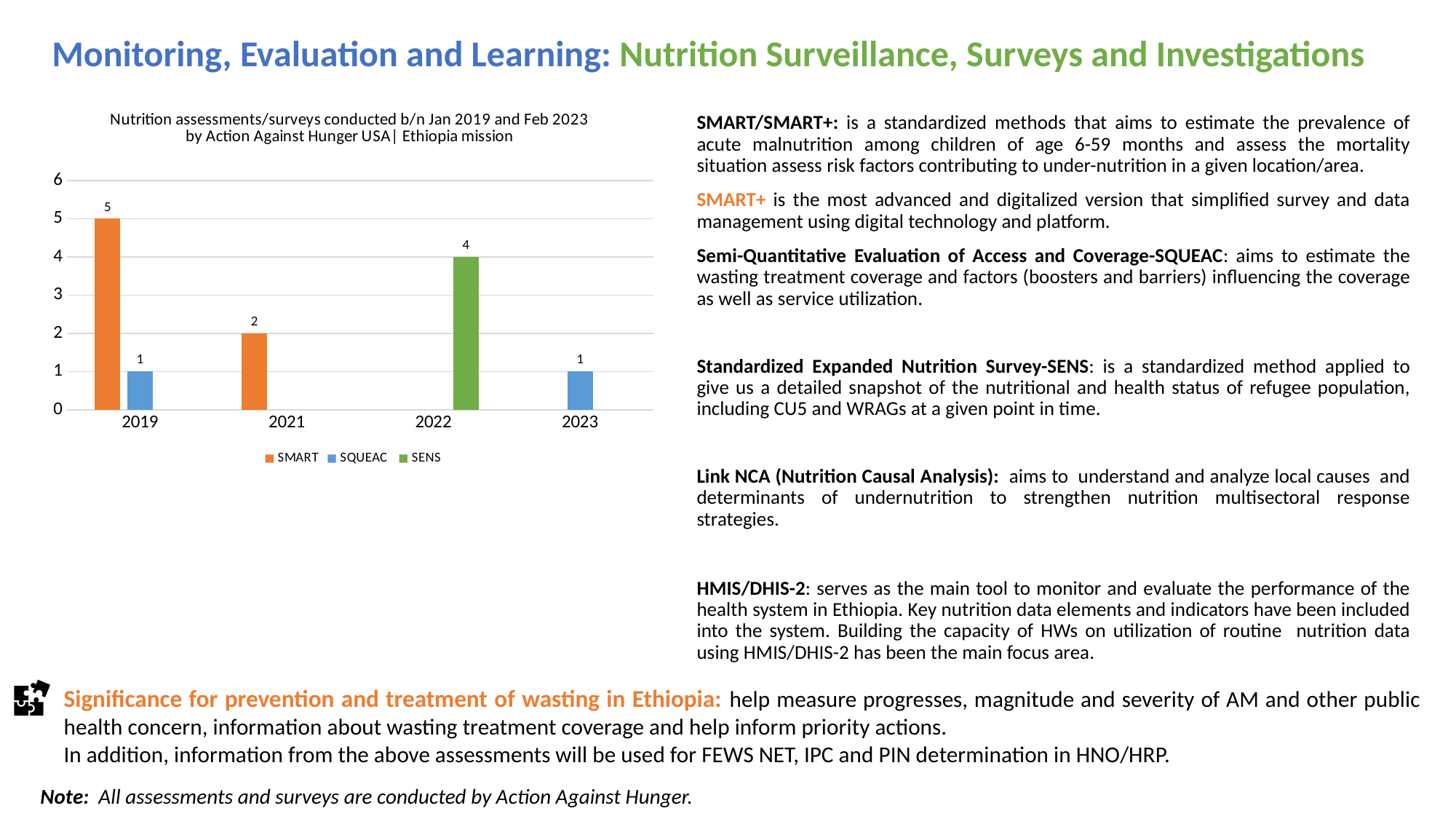
What is the difference between the SMART value in 2019 and the SMART value in 2021? 3 Which is larger: the SENS value in 2022 or the SQUEAC value in 2023? SENS value in 2022 What is the total number of assessments shown for 2019 across all series? 6 How many SMART surveys were conducted in 2019? 5 How many series does the chart legend list? 3 What is the value for SQUEAC in 2023? 1 How many SENS surveys were conducted in 2022? 4 How many years are shown on the x axis of the chart? 4 What kind of chart is shown on the slide? Bar chart Which year has the highest SMART value? 2019 Which series is shown in green in the chart? SENS What is the value for SMART in 2021? 2